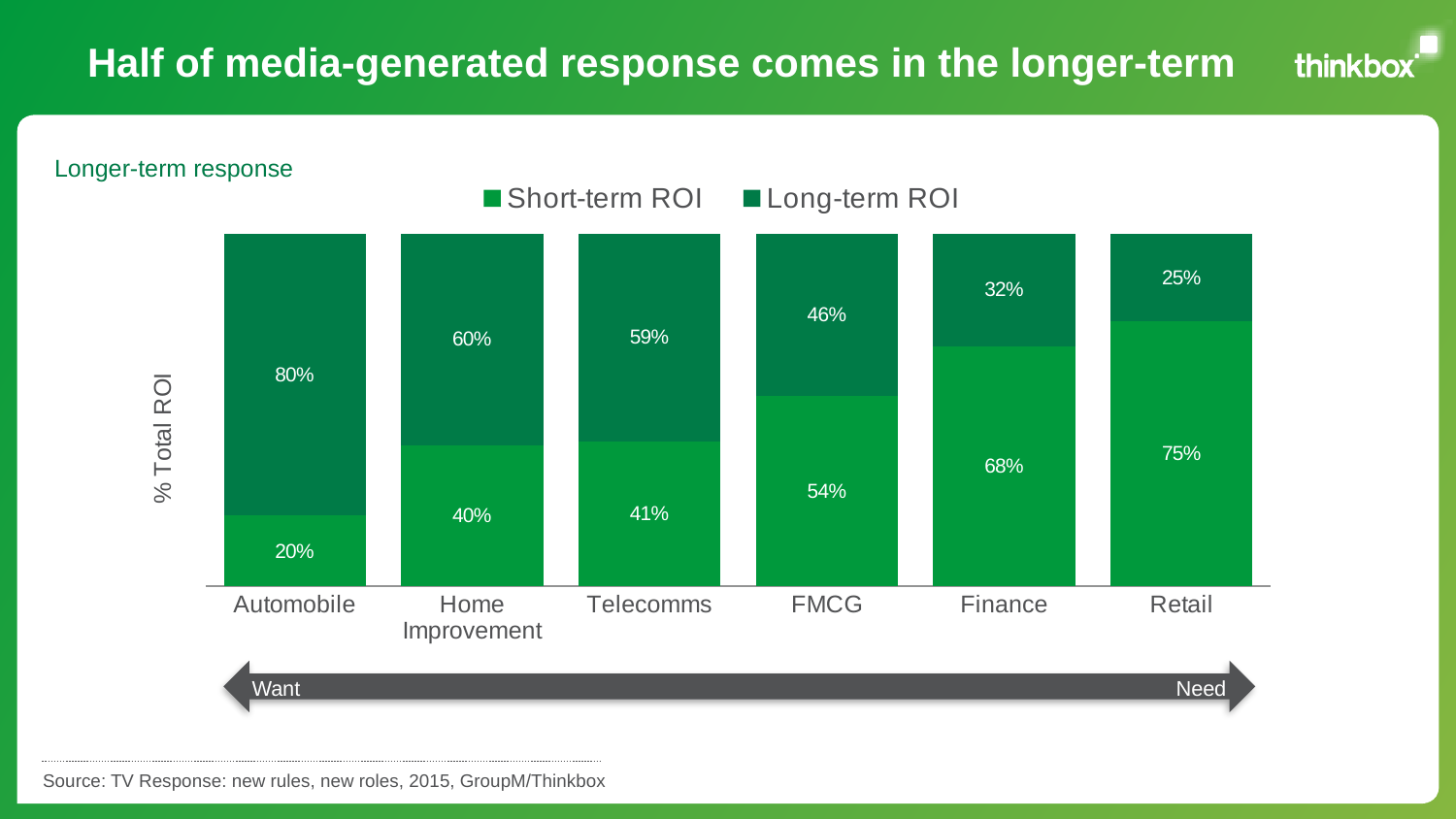
Which is larger: the Short-term ROI for Telecomms or the Short-term ROI for Finance? Finance What is the difference between the Long-term ROI for Home Improvement and for Retail? 35% What is the Long-term ROI value for Finance? 32% How many categories are shown on the x axis? 6 What is the total of the stacked bar for Retail? 100% Which category has the highest Long-term ROI? Automobile What is the Short-term ROI value for Automobile? 20% What is the Short-term ROI value for FMCG? 54% What is the label on the y axis? % Total ROI What kind of chart is shown on the slide? Stacked bar chart How many series does the legend list? 2 Which category has the lowest Short-term ROI? Automobile